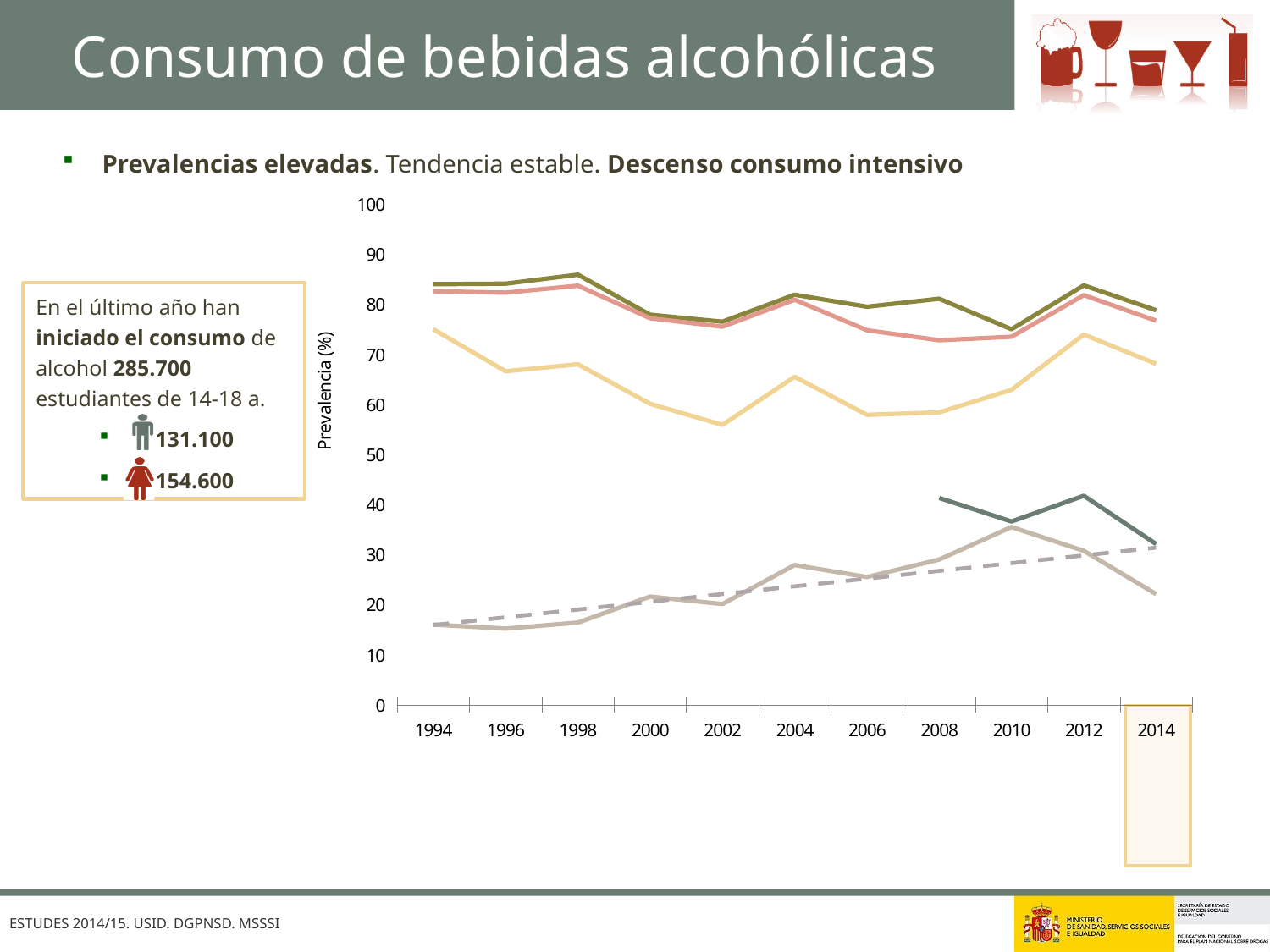
What kind of chart is shown on the slide? line chart What is the first year shown on the horizontal axis of the chart? 1994 What is the maximum value shown on the vertical axis of the chart? 100 How many years are marked on the horizontal axis of the chart? 11 Is the value of the yellow line in 2002 greater or less than 60? less What is the last year shown on the horizontal axis of the chart? 2014 What is the label of the vertical axis of the chart? Prevalencia (%) In which year does the dark green line in the lower part of the chart begin? 2008 Is the value of the topmost (olive) line in 1998 greater or less than 80? greater Is the value of the yellow line in 2014 greater or less than 70? less Does the dashed line in the chart rise or fall from 1994 to 2014? rise